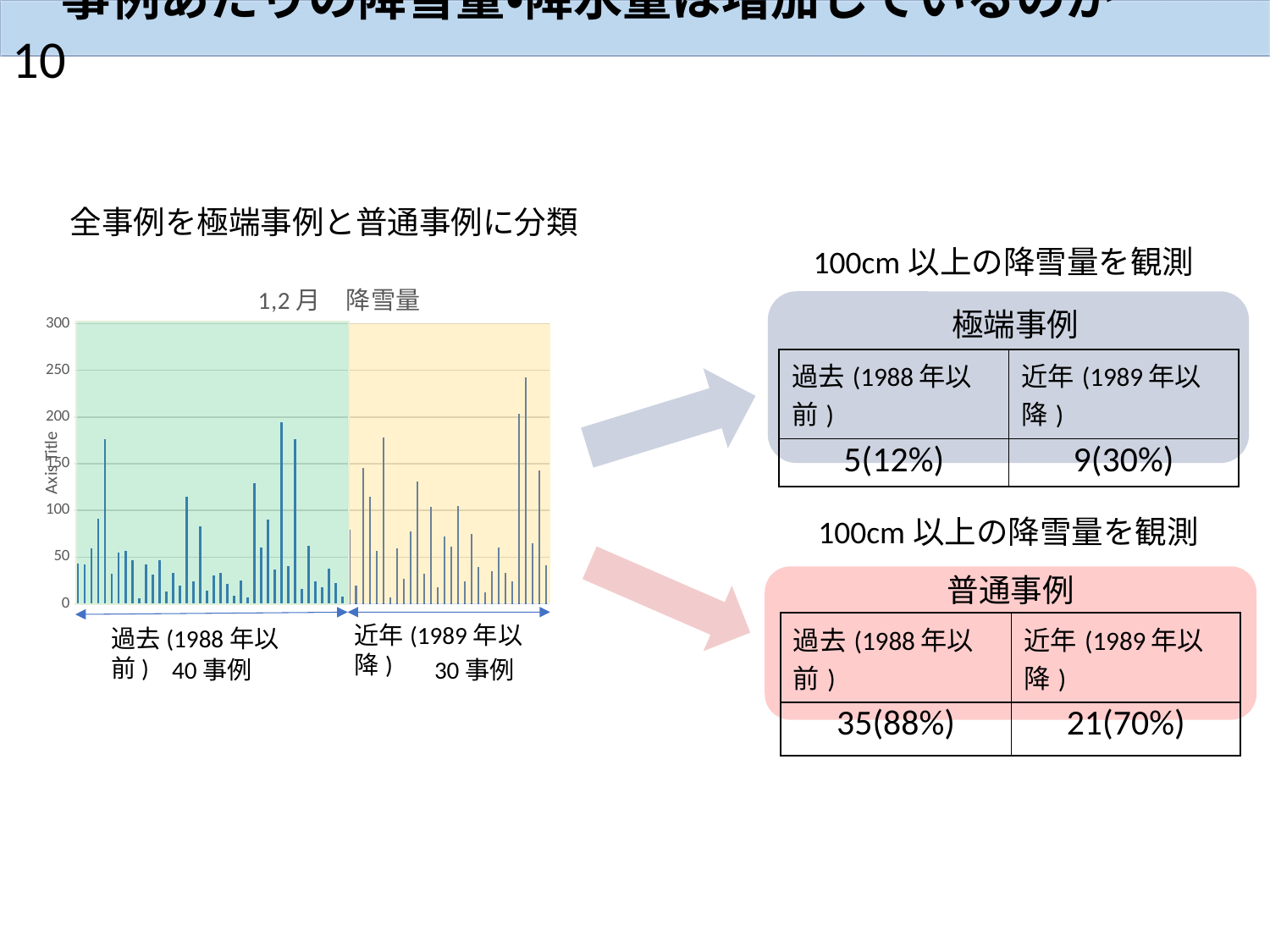
What kind of chart is shown on the slide? bar chart What is the title of the chart? 1,2月 降雪量 Which region of the chart, 過去 (1988年以前) or 近年 (1989年以降), contains the tallest bar? 近年 (1989年以降) What is the label on the chart's vertical axis? Axis Title How many cases (事例) are in the 近年 (1989年以降) region of the chart? 30 事例 Is the tallest bar in the 過去 (1988年以前) region greater or less than 250? less How many cases (事例) are in the 過去 (1988年以前) region of the chart? 40 事例 Is the tallest bar in the chart greater or less than 200? greater How many cases in total are plotted across the 過去 and 近年 regions of the chart? 70